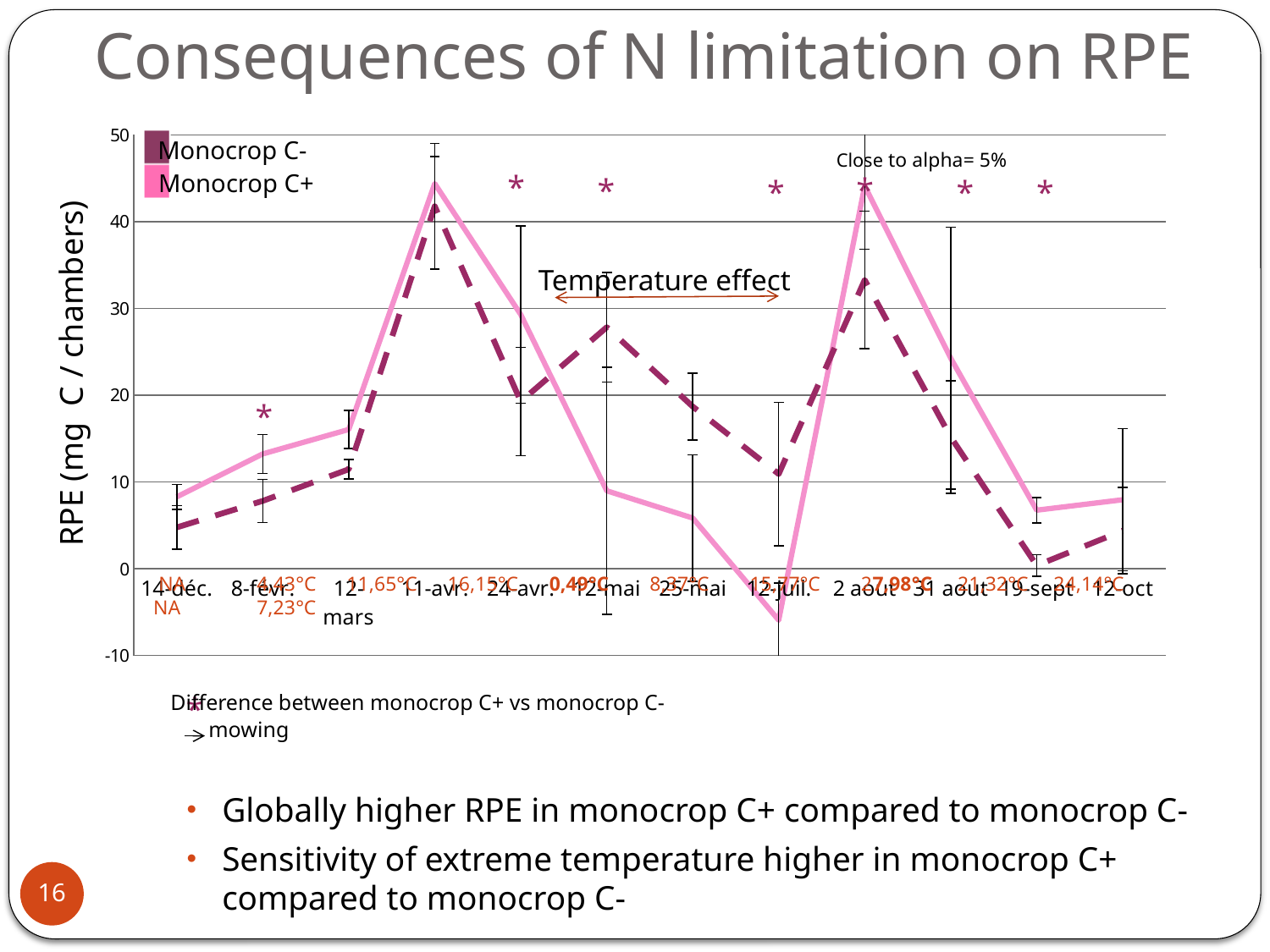
Does the Monocrop C+ line rise or fall from 11-avr. to 12-juil.? fall Is the value for Monocrop C+ on 11-avr. greater or less than 40? greater How many series does the legend list? 2 Is the value for Monocrop C+ on 12-juil. greater or less than 0? less Which date has the lowest value for Monocrop C+? 12-juil. Is the value for Monocrop C- on 12-mai greater or less than 30? less On 12-mai, which series has the larger value, Monocrop C+ or Monocrop C-? Monocrop C- How many dates are plotted along the x axis? 12 Which date has the lowest value for Monocrop C-? 19-sept Which date has the highest value for Monocrop C-? 11-avr. What kind of chart is shown on the slide? line chart What is the label of the y axis? RPE (mg C / chambers)